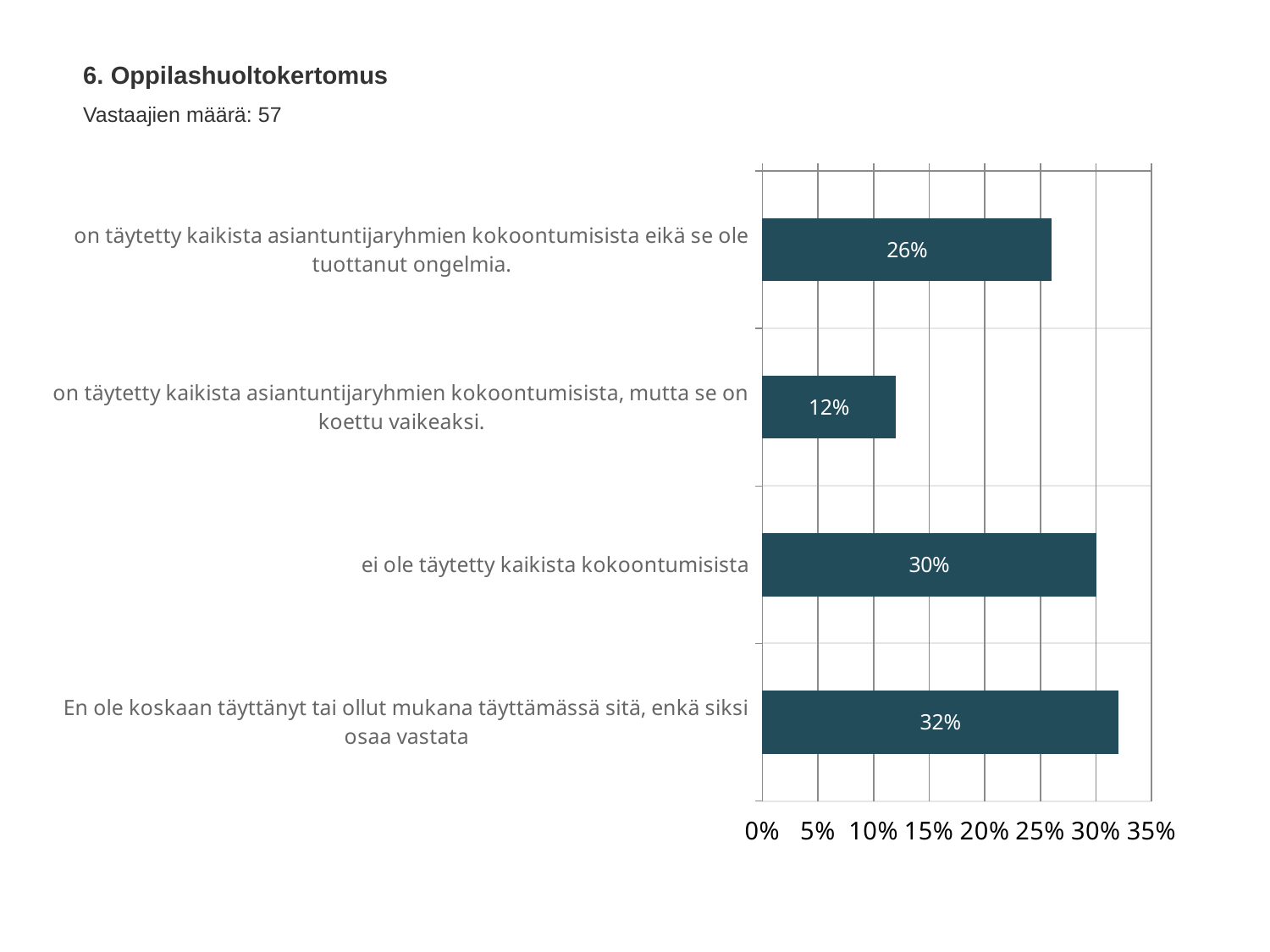
What percentage of respondents chose "En ole koskaan täyttänyt tai ollut mukana täyttämässä sitä, enkä siksi osaa vastata"? 32% Which is larger: the value for "ei ole täytetty kaikista kokoontumisista" or for "on täytetty kaikista asiantuntijaryhmien kokoontumisista eikä se ole tuottanut ongelmia."? ei ole täytetty kaikista kokoontumisista What percentage is shown for "ei ole täytetty kaikista kokoontumisista"? 30% What is the difference between the values for "ei ole täytetty kaikista kokoontumisista" and "on täytetty kaikista asiantuntijaryhmien kokoontumisista, mutta se on koettu vaikeaksi."? 18% What is the value for "on täytetty kaikista asiantuntijaryhmien kokoontumisista, mutta se on koettu vaikeaksi."? 12% Is the value for "on täytetty kaikista asiantuntijaryhmien kokoontumisista eikä se ole tuottanut ongelmia." greater or less than 20%? greater What kind of chart is shown on the slide? Bar chart What is the value for "on täytetty kaikista asiantuntijaryhmien kokoontumisista eikä se ole tuottanut ongelmia."? 26% What is the number of respondents stated on the slide? 57 Which category has the lowest value? on täytetty kaikista asiantuntijaryhmien kokoontumisista, mutta se on koettu vaikeaksi. Which category has the highest value? En ole koskaan täyttänyt tai ollut mukana täyttämässä sitä, enkä siksi osaa vastata How many categories are shown in the chart? 4